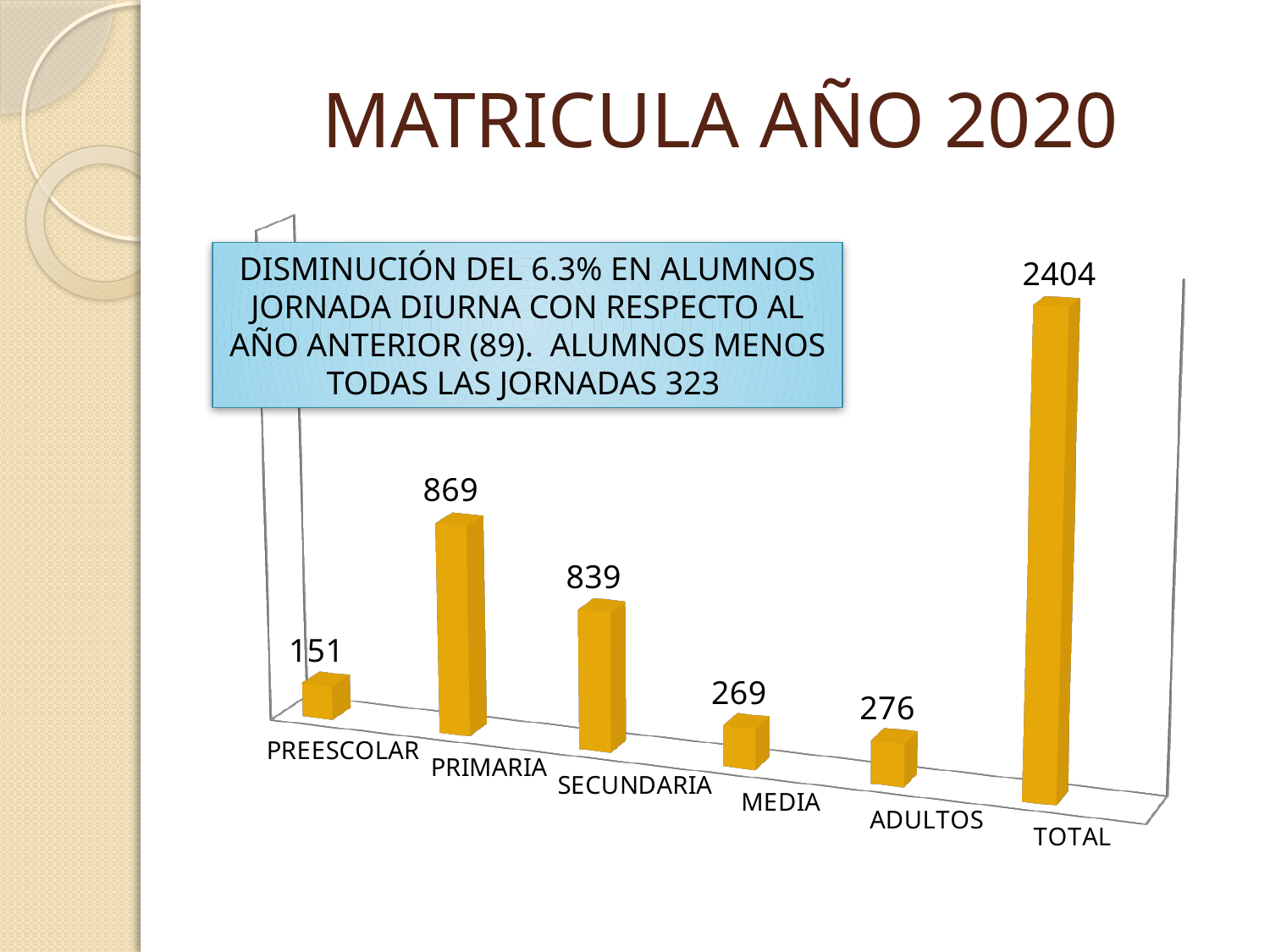
What is the difference between the values for PRIMARIA and SECUNDARIA? 30 What is the value for PREESCOLAR? 151 What is the difference between the values for ADULTOS and MEDIA? 7 What is the value shown for TOTAL? 2404 Which is larger, the value for MEDIA or the value for PREESCOLAR? MEDIA What is the value for SECUNDARIA? 839 Excluding the TOTAL bar, which category has the highest value? PRIMARIA Which category has the lowest value? PREESCOLAR How many bars are plotted in the chart? 6 What kind of chart is shown on the slide? Bar chart What is the value for ADULTOS? 276 What is the value for PRIMARIA? 869